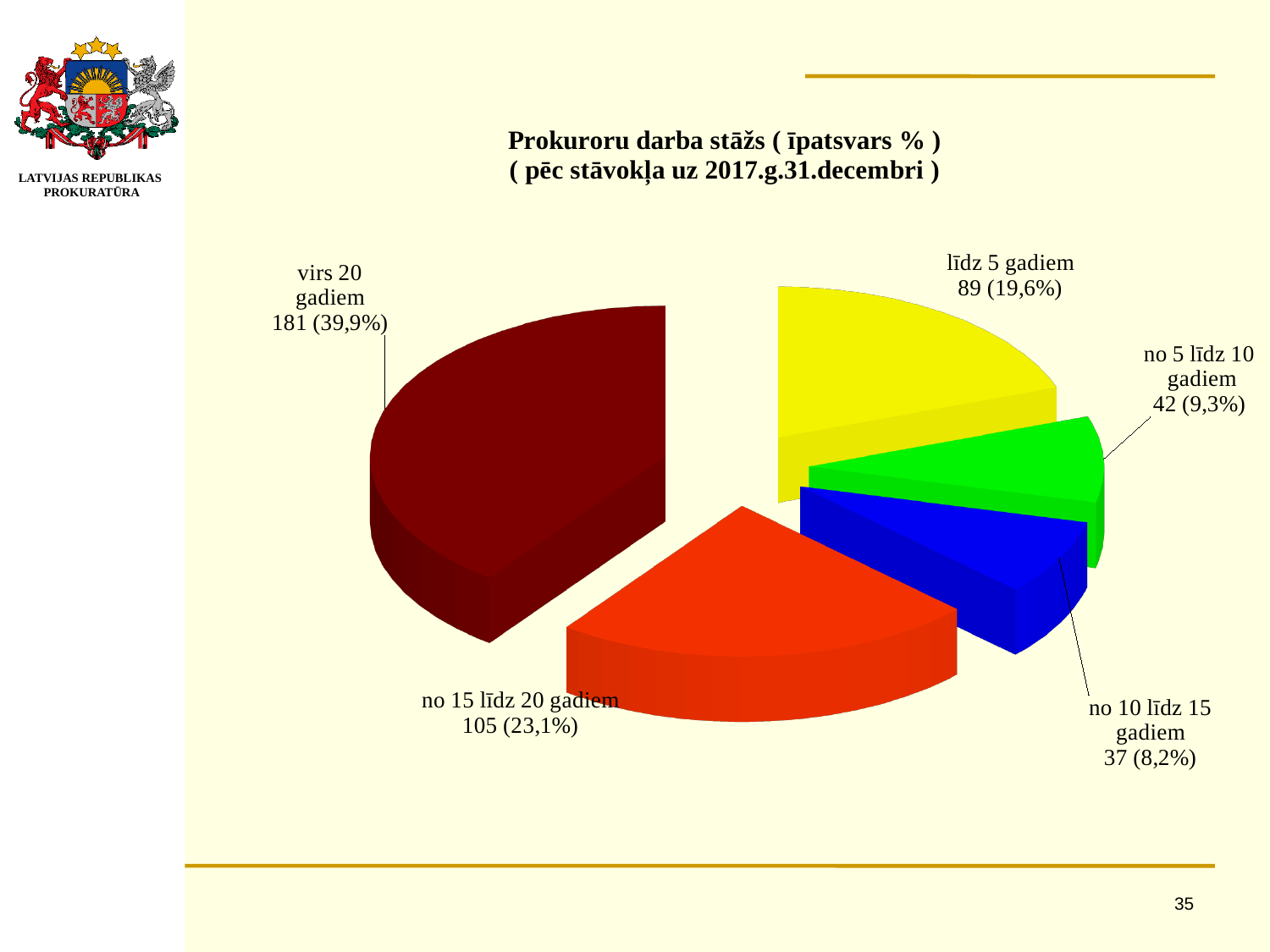
What is the value shown for the slice "no 5 līdz 10 gadiem"? 42 (9,3%) What is the value shown for the slice "līdz 5 gadiem"? 89 (19,6%) What percentage share of the pie does "virs 20 gadiem" have? 39,9% What colour is the slice for "no 15 līdz 20 gadiem"? Red (orange-red) Which category has the largest slice of the pie? virs 20 gadiem What is the value shown for the slice "no 15 līdz 20 gadiem"? 105 (23,1%) How many slices does the pie chart have? 5 What is the value shown for the slice "no 10 līdz 15 gadiem"? 37 (8,2%) What kind of chart is shown on the slide? Pie chart Which category has the smallest slice of the pie? no 10 līdz 15 gadiem What is the difference in count between "virs 20 gadiem" and "no 15 līdz 20 gadiem"? 76 Which is larger, the count for "līdz 5 gadiem" or for "no 5 līdz 10 gadiem"? līdz 5 gadiem